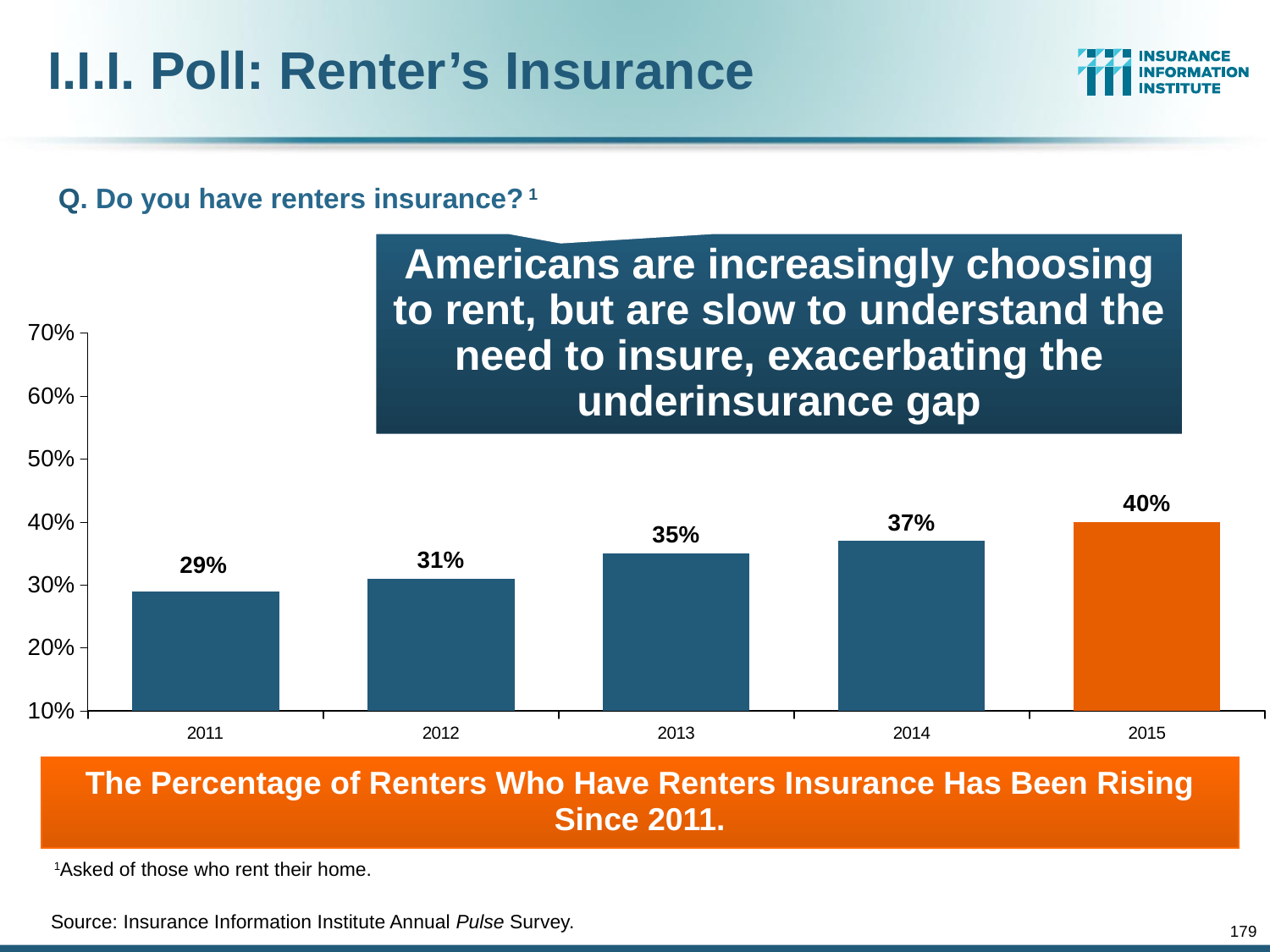
What percentage of renters had renters insurance in 2011? 29% Which year has a higher value, 2012 or 2014? 2014 Which year has the highest percentage of renters with renters insurance? 2015 What is the value shown for 2013? 35% What is the difference between the 2014 and 2012 values? 6 percentage points Is the value for 2013 greater or less than 30%? greater Do the values rise or fall from 2011 to 2015? Rise What is the value shown for 2015? 40% What kind of chart is shown on the slide? Bar chart How many years are shown on the chart? 5 By how many percentage points did the value increase from 2011 to 2015? 11 percentage points Which year has the lowest percentage of renters with renters insurance? 2011